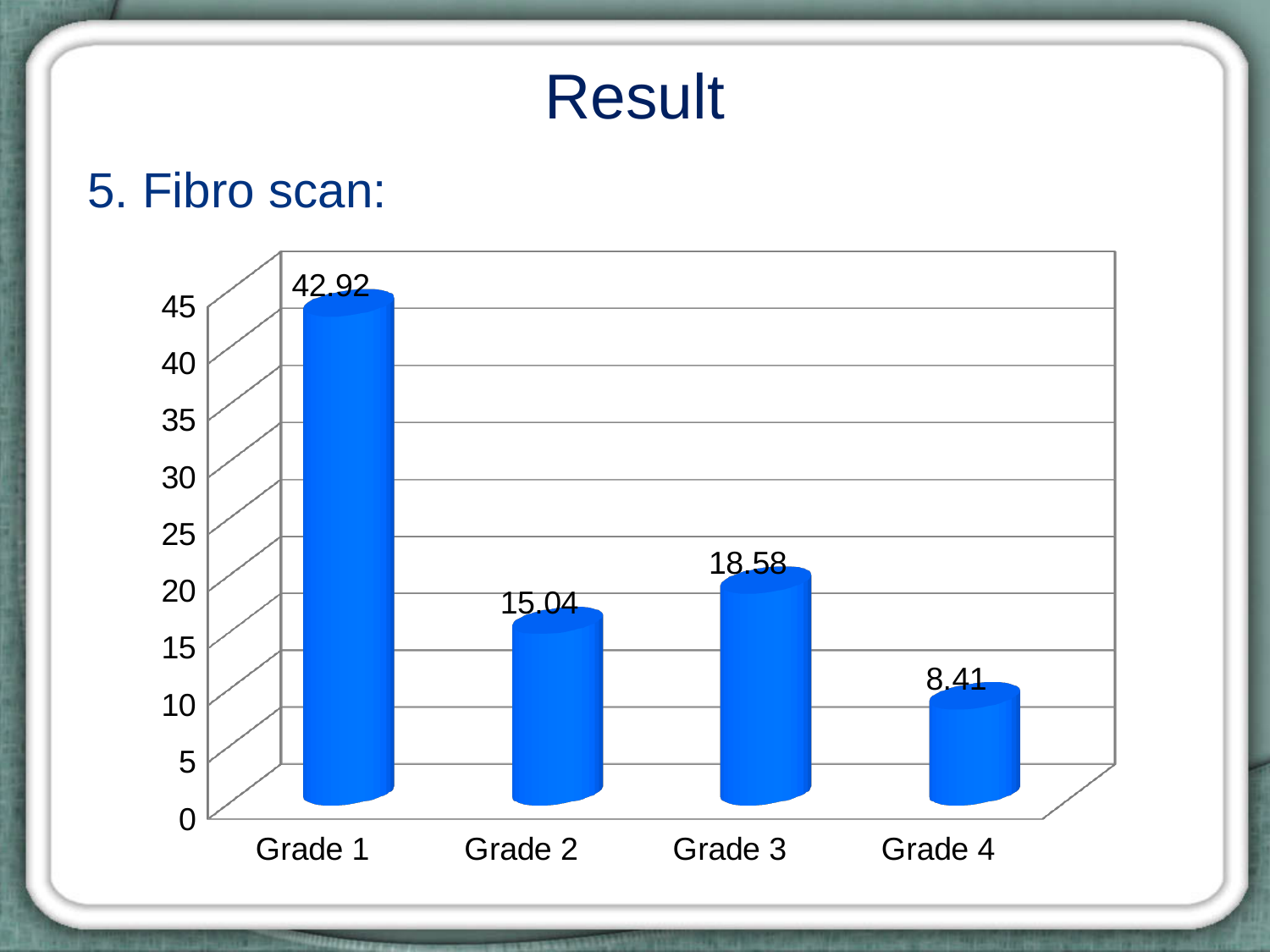
Which grade has the highest value? Grade 1 What kind of chart is shown on the slide? Bar chart Which grade has the lowest value? Grade 4 What is the difference between the values for Grade 3 and Grade 2? 3.54 What is the heading above the chart? 5. Fibro scan: How many grades are shown on the chart? 4 Which is larger, the value for Grade 2 or the value for Grade 3? Grade 3 What is the value for Grade 4? 8.41 What is the value for Grade 2? 15.04 What is the value for Grade 3? 18.58 What is the value for Grade 1? 42.92 What is the difference between the values for Grade 1 and Grade 4? 34.51